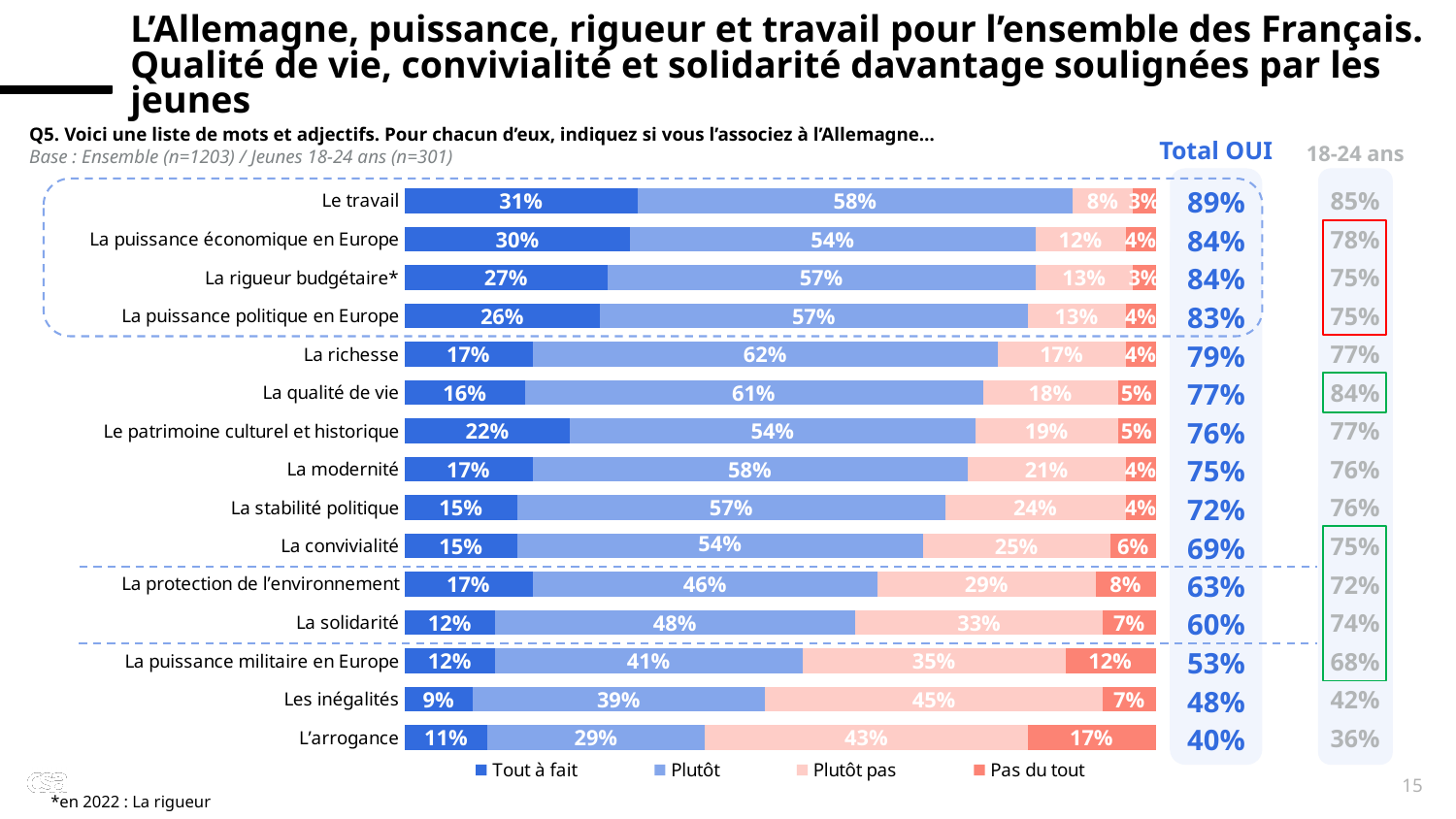
How many items (categories) are listed in the chart? 15 What is the "Plutôt" value for "La richesse"? 62% What is the "Total OUI" value shown for "La convivialité"? 69% What percentage of respondents answered "Tout à fait" for "Le travail"? 31% Which has the larger "Plutôt" value, "La modernité" or "La convivialité"? La modernité Which item has the highest "Tout à fait" value? Le travail What is the "18-24 ans" value shown for "La solidarité"? 74% Which item has the lowest "Tout à fait" value? Les inégalités What kind of chart is shown on the slide? Stacked bar chart What is the "Pas du tout" value for "L'arrogance"? 17% How many series does the legend list? 4 What is the difference between the "Plutôt pas" values for "La solidarité" and "La richesse"? 16 percentage points